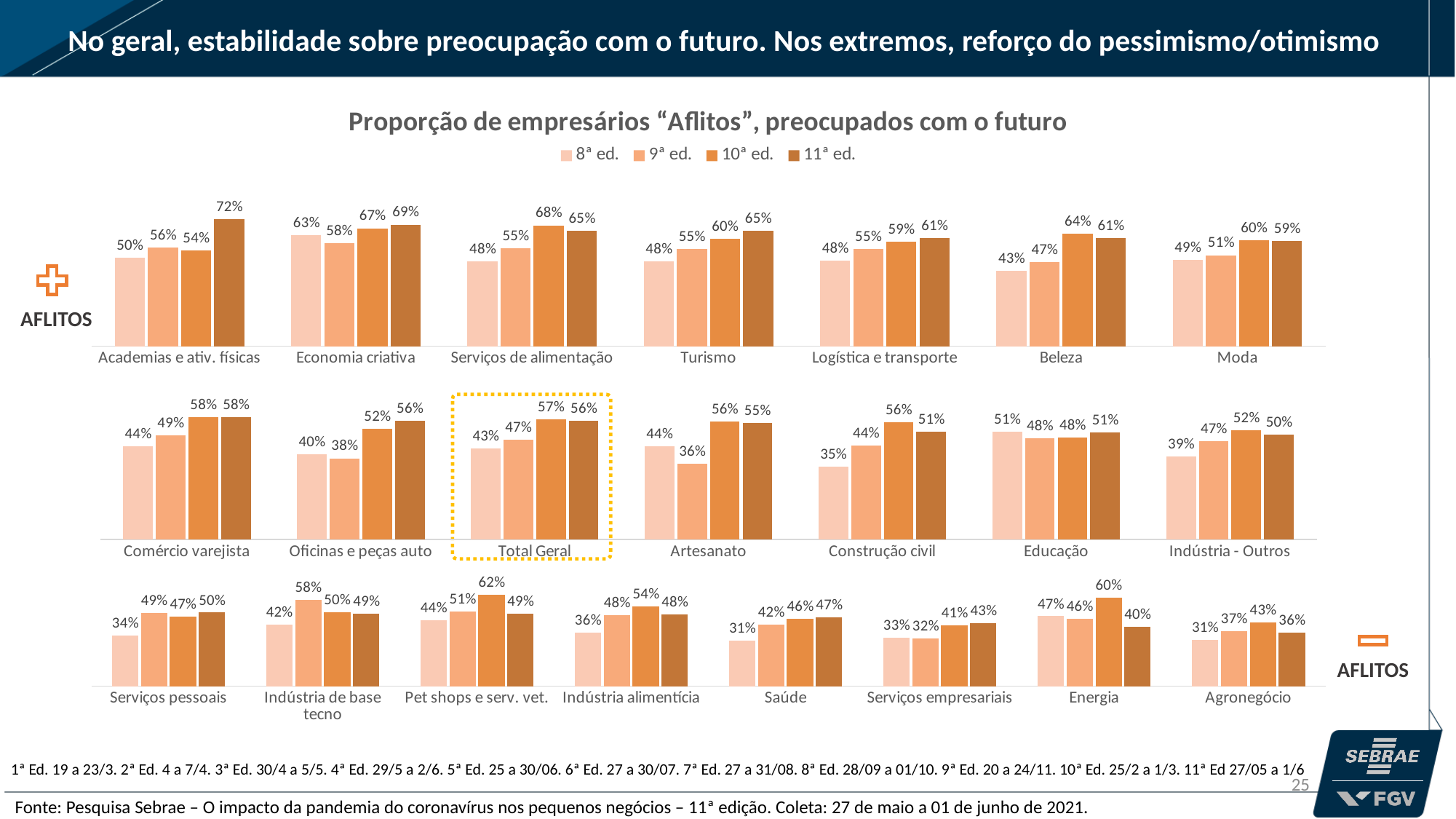
What is the value for Energia in the 10ª ed. series? 60% What is the value for Academias e ativ. físicas in the 11ª ed. series? 72% How many categories are shown in the chart? 22 What is the difference between the 10ª ed. and 11ª ed. values for Energia? 20% Which is larger for Beleza: the 10ª ed. value or the 11ª ed. value? 10ª ed. Which category has the highest value in the 11ª ed. series? Academias e ativ. físicas Which category has the lowest value in the 11ª ed. series? Agronegócio What is the value for Total Geral in the 11ª ed. series? 56% Which category is highlighted with a dashed yellow box? Total Geral What is the difference between the 11ª ed. and 8ª ed. values for Academias e ativ. físicas? 22% What kind of chart is shown on the slide? Bar chart How many series does the legend list? 4